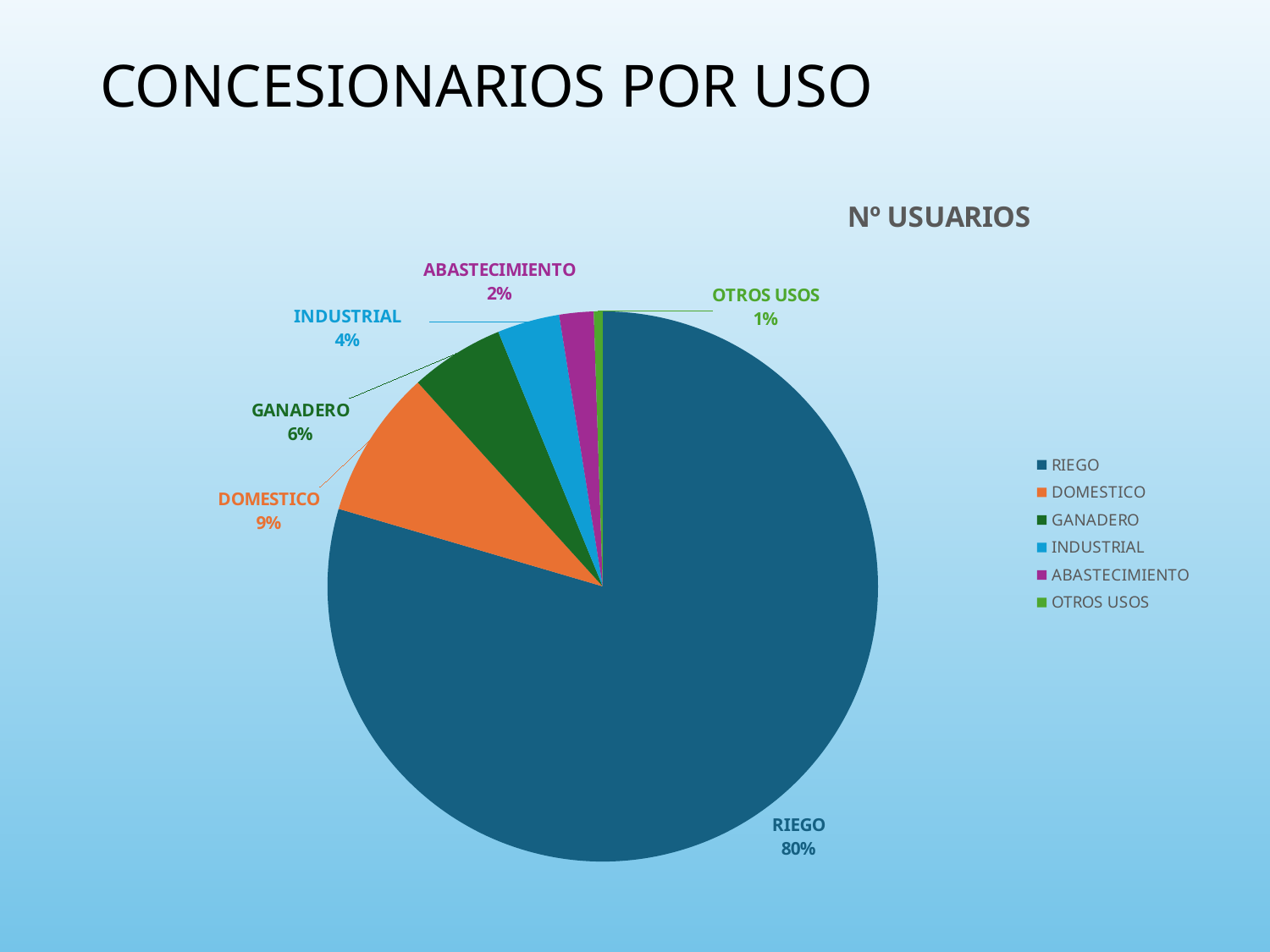
Which category has the largest slice of the pie? RIEGO What kind of chart is shown on the slide? pie chart What share of the pie does GANADERO have? 6% What share of the pie does INDUSTRIAL have? 4% Which is larger, the share for GANADERO or the share for INDUSTRIAL? GANADERO What share of the pie does DOMESTICO have? 9% What is the chart's title? Nº USUARIOS What is the difference in percentage points between RIEGO and DOMESTICO? 71 How many categories does the legend list? 6 Which category has the smallest slice of the pie? OTROS USOS